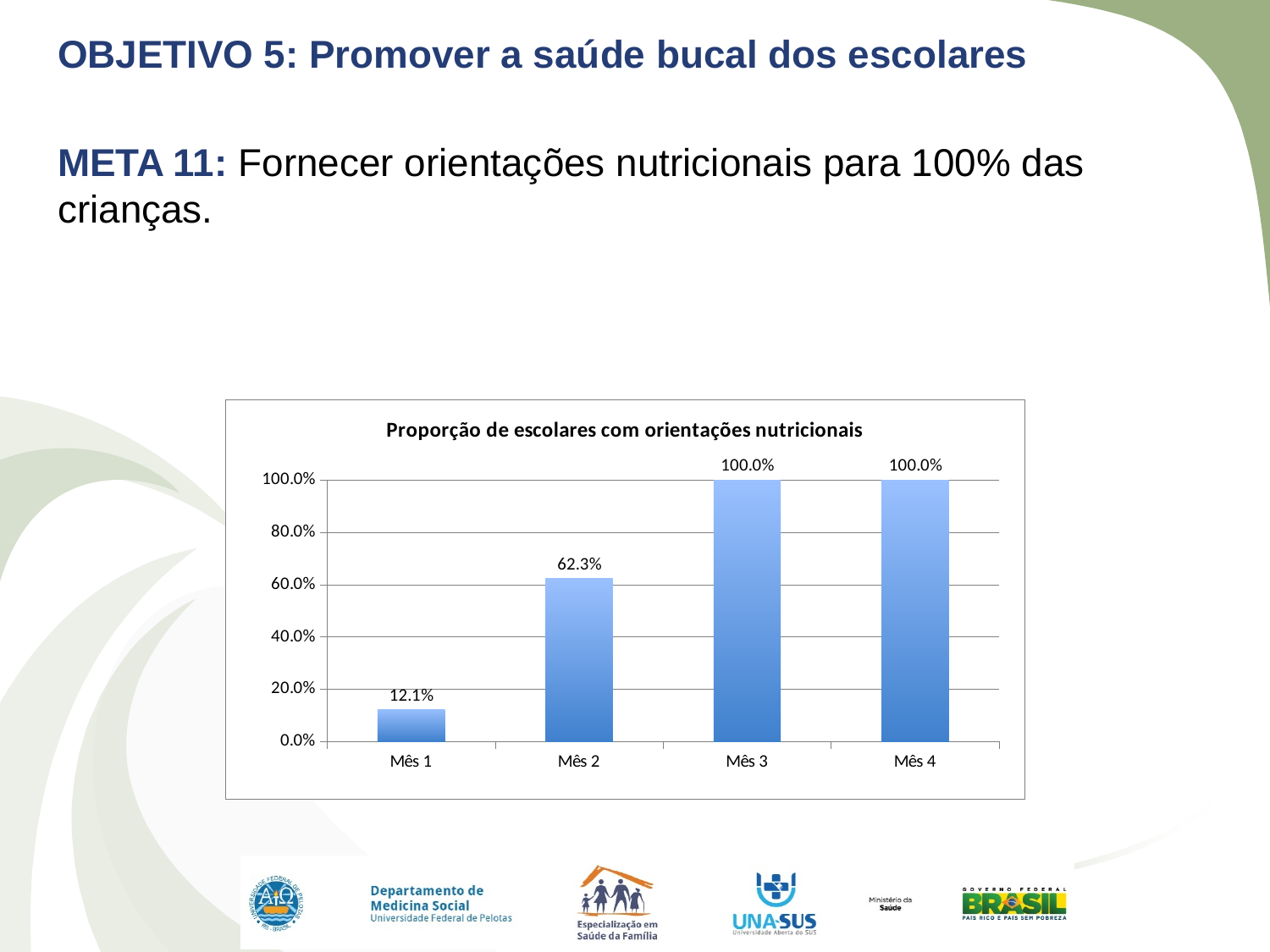
What is the difference between the values for Mês 3 and Mês 2? 37.7% Which is larger, the value for Mês 2 or the value for Mês 1? Mês 2 Which month has the lowest value? Mês 1 How many months are shown on the x axis? 4 What is the value for Mês 2? 62.3% What is the value for Mês 3? 100.0% What is the title of the chart? Proporção de escolares com orientações nutricionais Do the values rise or fall from Mês 1 to Mês 3? Rise What kind of chart is shown on the slide? Bar chart What is the value for Mês 1? 12.1% What is the difference between the values for Mês 2 and Mês 1? 50.2% Is the value for Mês 2 greater or less than 60.0%? greater